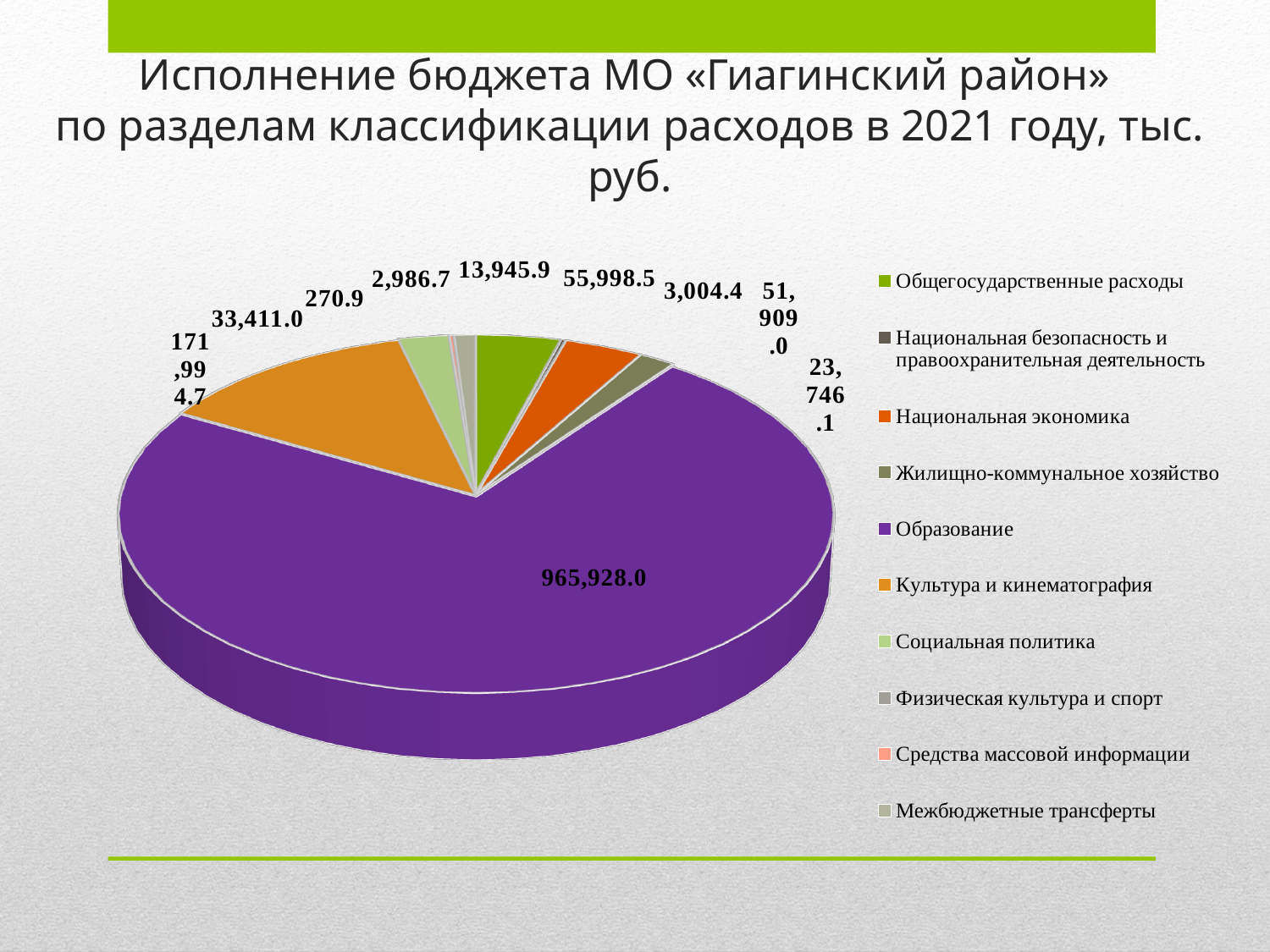
What is the value for Культура и кинематография? 171,994.7 Which is larger, the value for Культура и кинематография or the value for Социальная политика? Культура и кинематография In what units are the values on the chart expressed, according to the title? тыс. руб. Which category has the largest slice of the pie? Образование What is the difference between the values for Образование and Культура и кинематография? 793,933.3 What is the value for Социальная политика? 33,411.0 What is the smallest value printed on the chart? 270.9 What kind of chart is shown on the slide? pie chart How many categories does the legend list? 10 What is the value for Национальная экономика? 51,909.0 What is the value for Образование? 965,928.0 What share of the total does the Образование slice represent? 73%